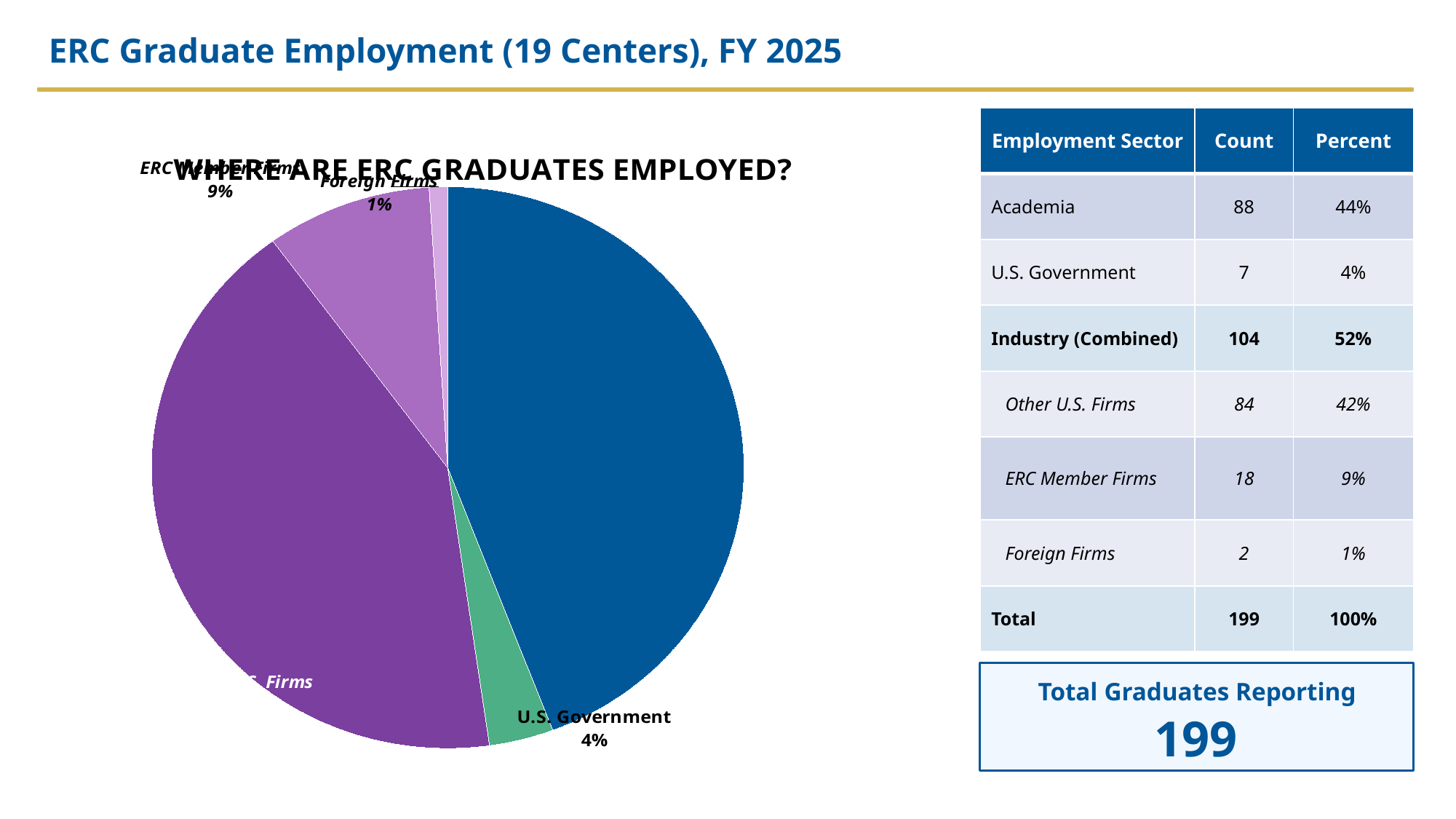
What is the difference in percentage points between the U.S. Government slice and the Foreign Firms slice? 3 What is the difference in percentage points between the ERC Member Firms slice and the U.S. Government slice? 5 Which slice is larger in the pie chart, U.S. Government or Foreign Firms? U.S. Government How many slices does the pie chart have? 5 What percentage of ERC graduates are employed by ERC Member Firms according to the pie chart? 9% What is the title of the pie chart? WHERE ARE ERC GRADUATES EMPLOYED? What share of the pie does the Foreign Firms slice represent? 1% What percentage of ERC graduates are employed by the U.S. Government according to the pie chart? 4% What colour is the U.S. Government slice in the pie chart? green What percentage of ERC graduates are employed by Foreign Firms according to the pie chart? 1% What kind of chart is shown on the slide? pie chart Which slice is larger in the pie chart, ERC Member Firms or U.S. Government? ERC Member Firms